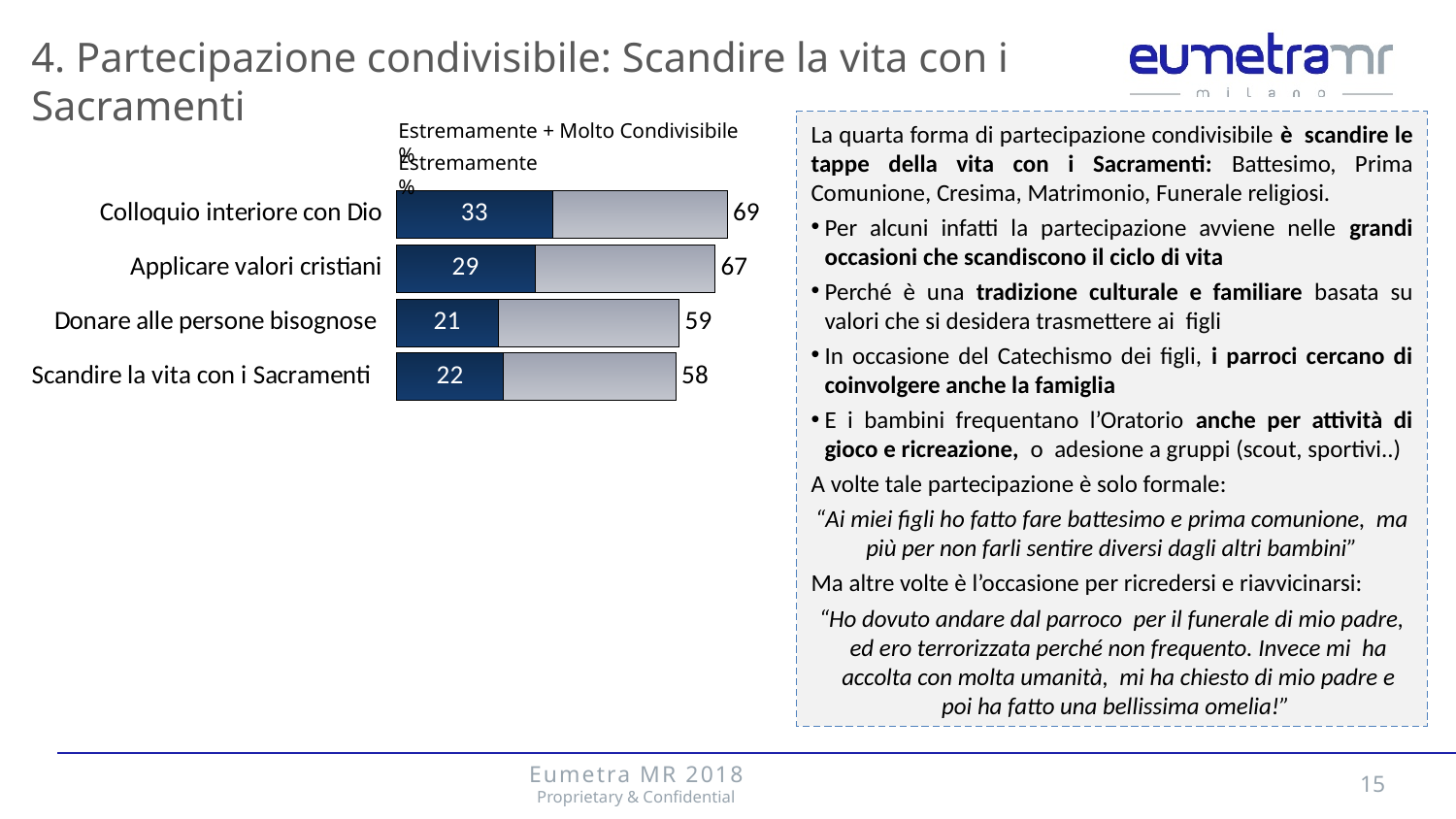
Which colour represents the 'Estremamente' series in the chart? Dark blue What is the difference between the 'Estremamente + Molto Condivisibile' values for 'Colloquio interiore con Dio' and 'Scandire la vita con i Sacramenti'? 11 What is the 'Estremamente' value for 'Scandire la vita con i Sacramenti'? 22 Which category has the lowest 'Estremamente' value? Donare alle persone bisognose How many categories are shown in the chart? 4 Which category has the highest 'Estremamente + Molto Condivisibile' value? Colloquio interiore con Dio What is the 'Estremamente' value for 'Applicare valori cristiani'? 29 What kind of chart is shown on the slide? Bar chart How many series does the chart legend list? 2 What is the 'Estremamente + Molto Condivisibile' value for 'Colloquio interiore con Dio'? 69 What is the 'Estremamente + Molto Condivisibile' value for 'Donare alle persone bisognose'? 59 Which is larger: the 'Estremamente' value for 'Colloquio interiore con Dio' or for 'Applicare valori cristiani'? Colloquio interiore con Dio